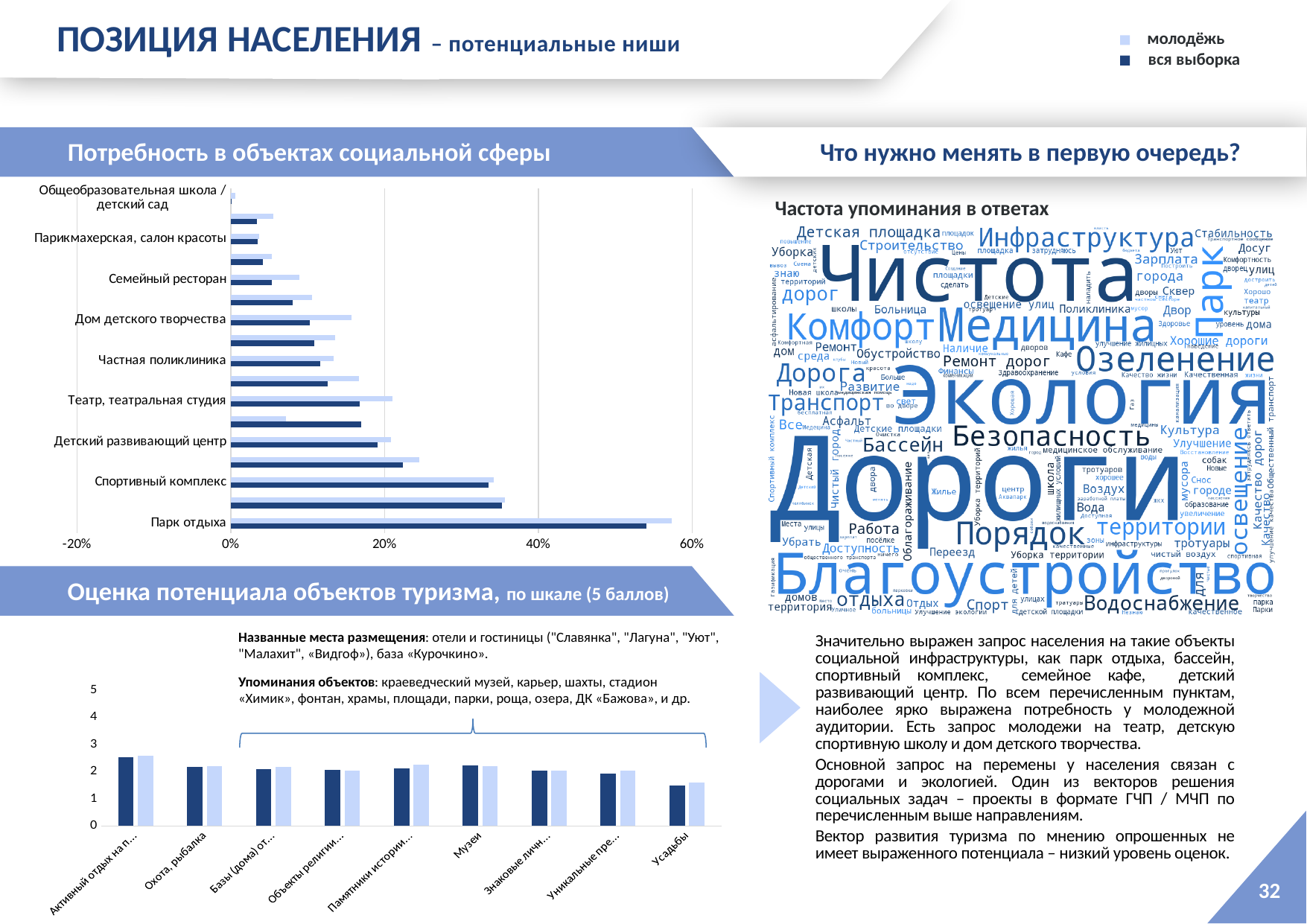
In the "Потребность в объектах социальной сферы" chart, which category has the highest value? Парк отдыха In the "Потребность в объектах социальной сферы" chart, which is larger for вся выборка: Парк отдыха or Спортивный комплекс? Парк отдыха In the "Потребность в объектах социальной сферы" chart, is the value for Парк отдыха (вся выборка) greater or less than 40%? greater What kind of chart is "Потребность в объектах социальной сферы"? bar chart In the "Оценка потенциала объектов туризма" chart, do the values generally rise or fall from left to right along the x axis? fall How many series does the legend list for the "Потребность в объектах социальной сферы" chart? 2 How many categories are shown on the x axis of the "Оценка потенциала объектов туризма" chart? 9 What kind of chart is "Оценка потенциала объектов туризма"? bar chart In the "Оценка потенциала объектов туризма" chart, which category has the lowest value? Усадьбы In the "Потребность в объектах социальной сферы" chart, is the value for Парк отдыха (молодёжь) greater or less than 60%? less In the "Потребность в объектах социальной сферы" chart, is the value for Спортивный комплекс (вся выборка) greater or less than 20%? greater